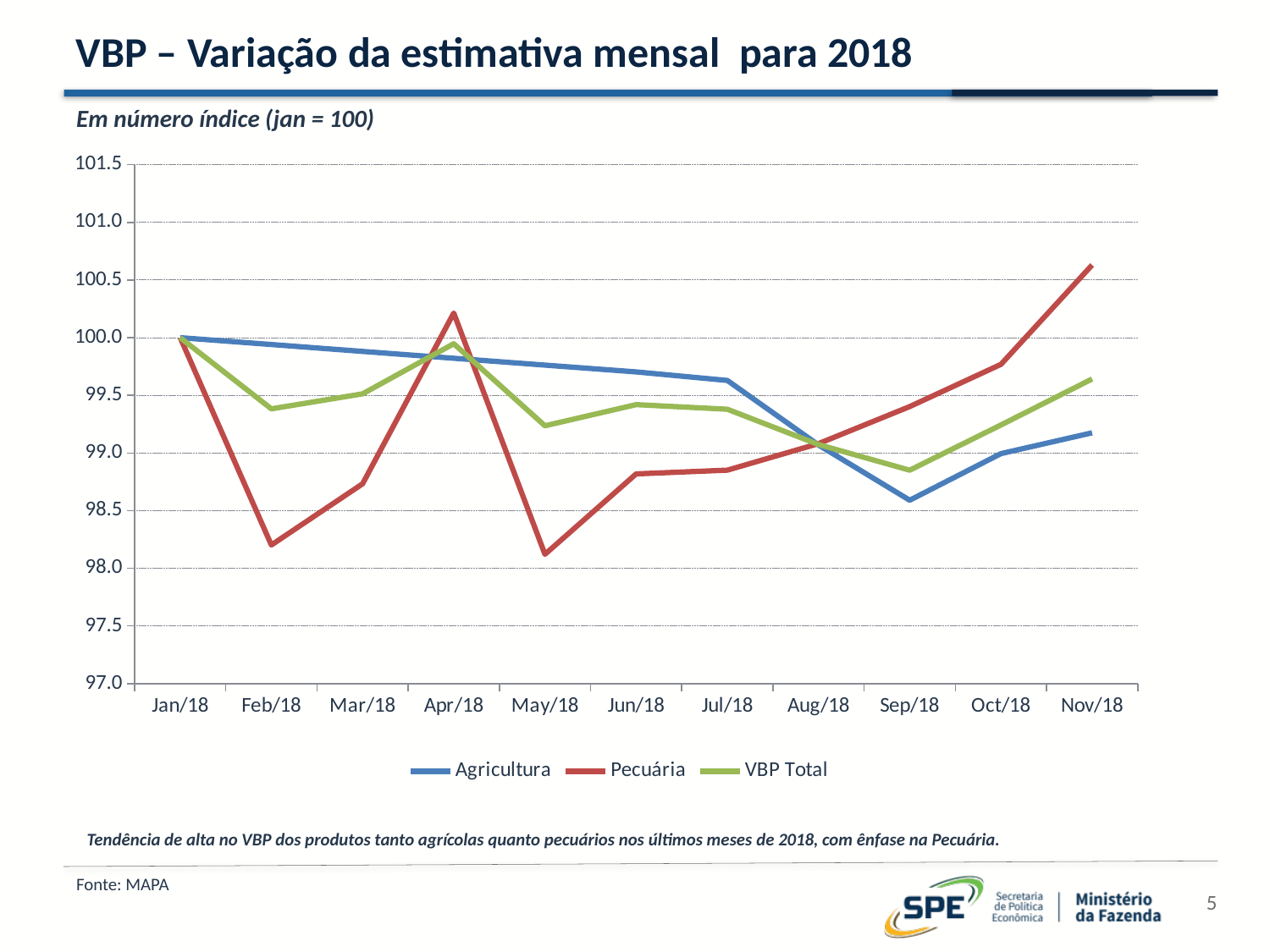
In which month does Agricultura reach its lowest value? Sep/18 Is the value for Pecuária in Feb/18 greater or less than 98.5? less Is the value for Agricultura in Sep/18 greater or less than 99.0? less Does the Agricultura line rise or fall from Jan/18 to Sep/18? fall In which month does Pecuária reach its highest value? Nov/18 What kind of chart is shown on the slide? line chart How many series does the legend list? 3 How many months are plotted along the x axis? 11 Is the value for Pecuária in Apr/18 greater or less than 100.0? greater What is the value of Agricultura in Jan/18? 100.0 What is the title of the chart on the slide? VBP – Variação da estimativa mensal para 2018 In Nov/18, which series is higher, Pecuária or Agricultura? Pecuária